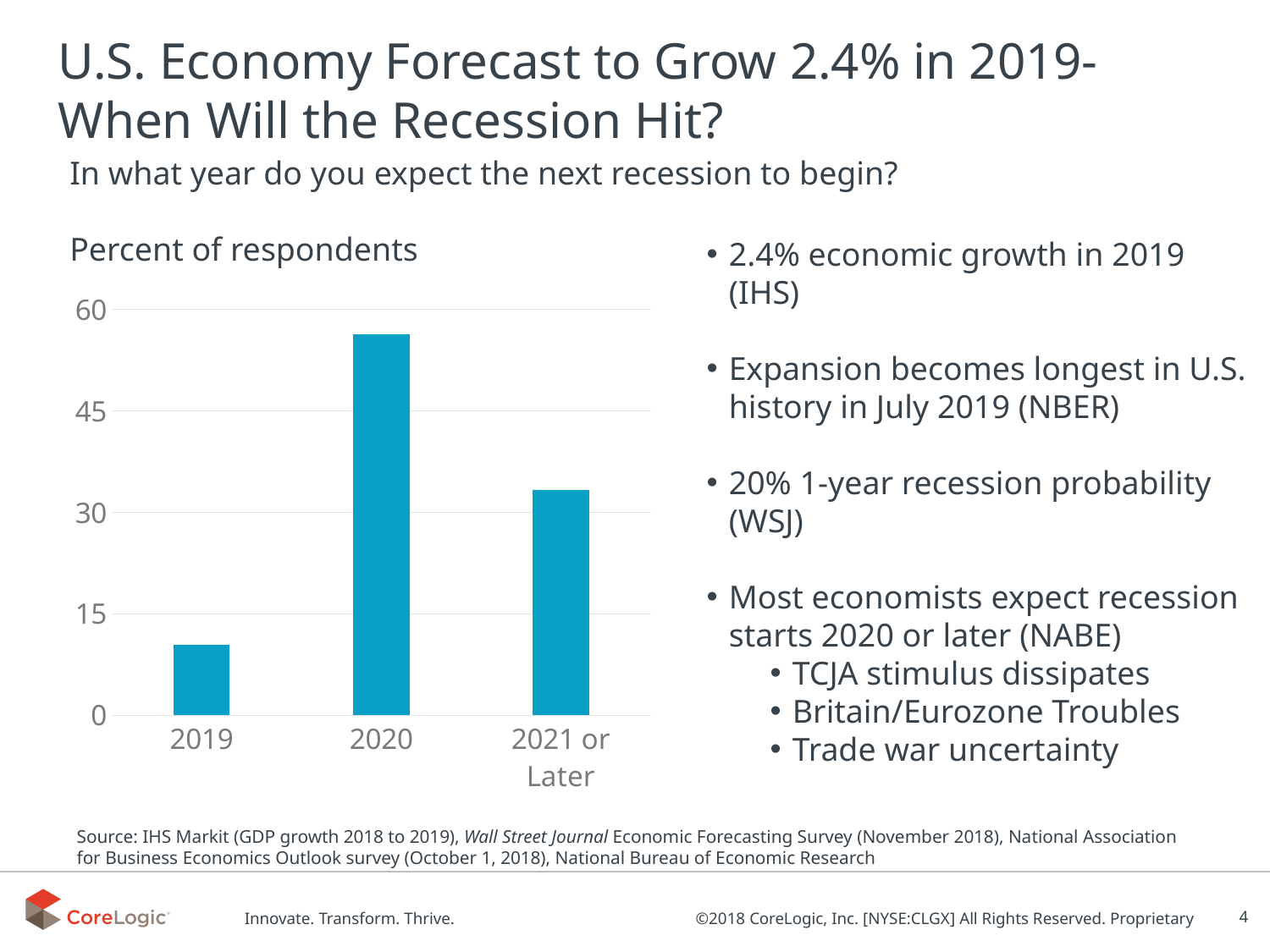
Which has a larger percent of respondents, 2020 or 2021 or Later? 2020 Which category has the highest percent of respondents? 2020 Is the value for 2020 greater or less than 45? greater How many categories are shown on the x axis of the chart? 3 Is the value for 2021 or Later greater or less than 30? greater What kind of chart is shown on the slide? bar chart What is the label on the vertical axis of the chart? Percent of respondents What question does the chart's heading say respondents were asked? In what year do you expect the next recession to begin? Is the value for 2021 or Later greater or less than 45? less Which category has the lowest percent of respondents? 2019 Which has a larger percent of respondents, 2019 or 2021 or Later? 2021 or Later